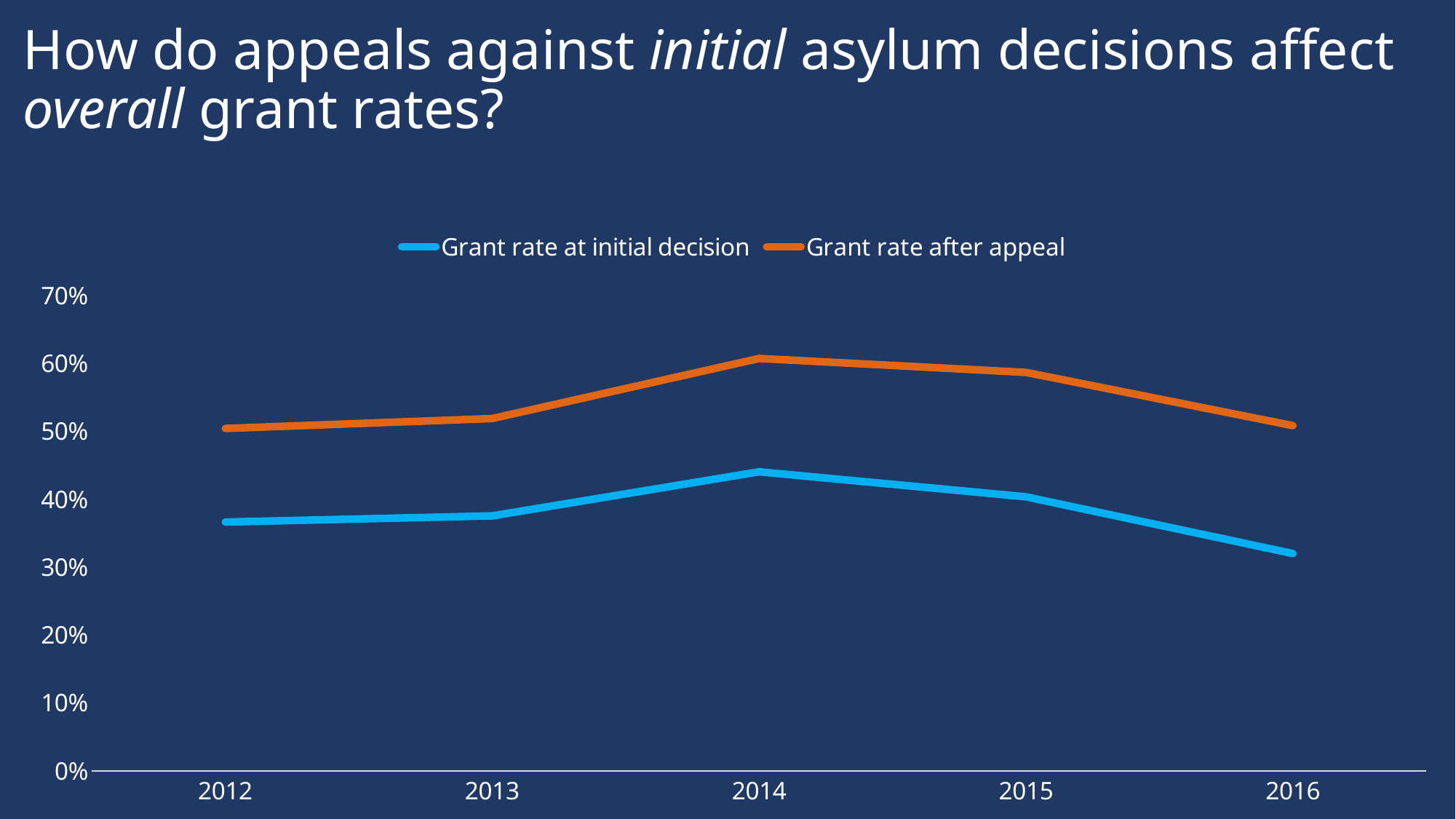
In which year is the grant rate after appeal highest? 2014 In which year is the grant rate at initial decision highest? 2014 Which colour is used for the 'Grant rate after appeal' line? orange Which is larger in 2016: the grant rate at initial decision or the grant rate after appeal? Grant rate after appeal Does the grant rate at initial decision rise or fall from 2014 to 2016? fall Is the grant rate at initial decision in 2014 greater or less than 40%? greater Is the grant rate after appeal in 2015 greater or less than 50%? greater What kind of chart is shown on the slide? line chart How many series does the legend list? 2 Is the grant rate at initial decision in 2016 greater or less than 40%? less In which year is the grant rate at initial decision lowest? 2016 How many years are plotted along the x axis? 5